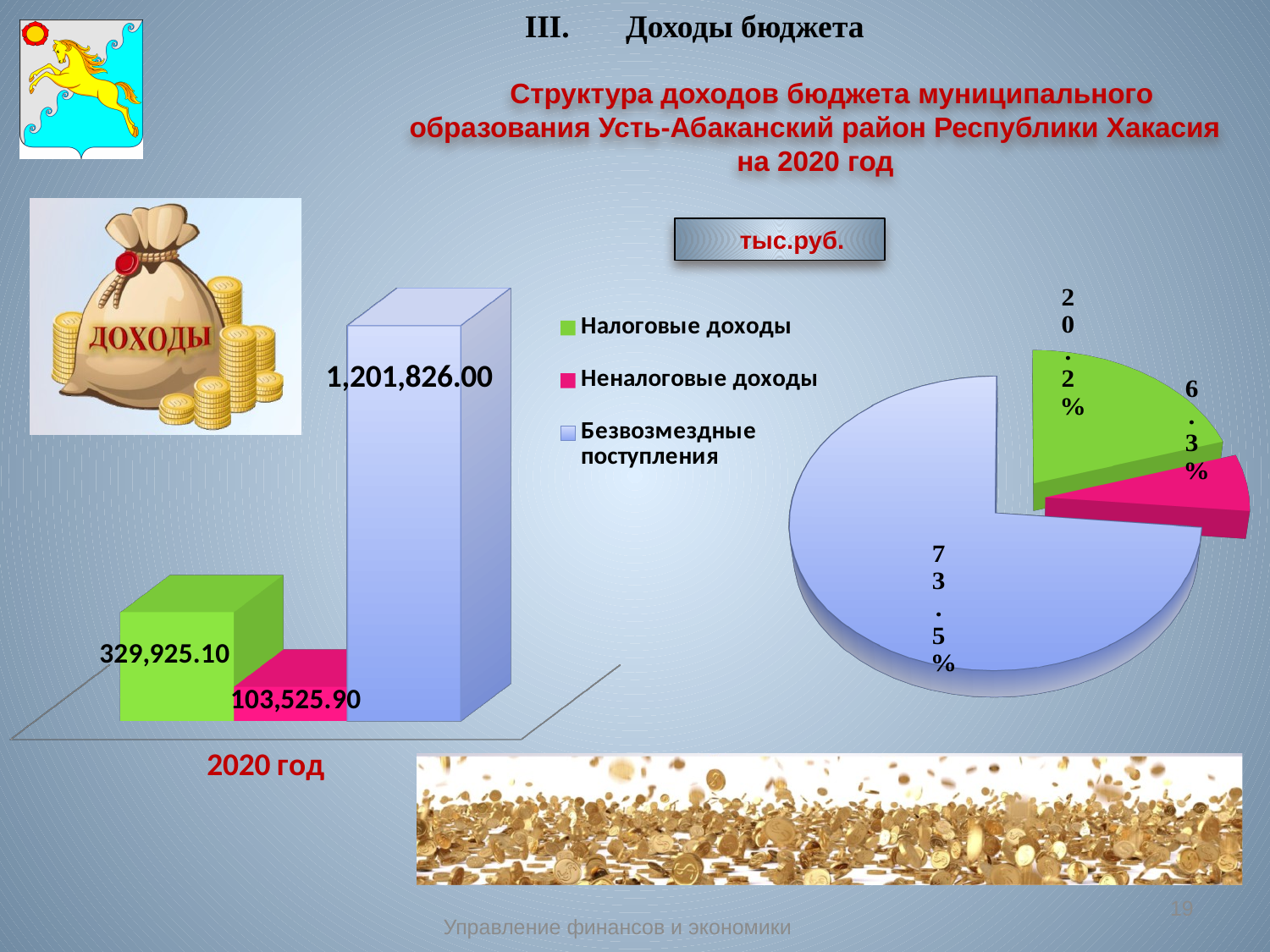
On the pie chart on the right, what share does the largest slice (Безвозмездные поступления) have? 73.5% On the bar chart on the left, which series has the highest value? Безвозмездные поступления On the bar chart on the left, what is the value for Безвозмездные поступления? 1,201,826.00 On the pie chart on the right, what share does the pink slice (Неналоговые доходы) have? 6.3% How many series does the legend list? 3 On the pie chart on the right, what share does the green slice (Налоговые доходы) have? 20.2% On the bar chart on the left, what is the value for Неналоговые доходы? 103,525.90 On the bar chart on the left, which series has the lowest value? Неналоговые доходы What kind of chart is shown on the left of the slide? Bar chart On the bar chart on the left, what is the value for Налоговые доходы? 329,925.10 On the bar chart on the left, what is the difference between Налоговые доходы and Неналоговые доходы? 226,399.20 On the bar chart on the left, which is larger: Налоговые доходы or Неналоговые доходы? Налоговые доходы